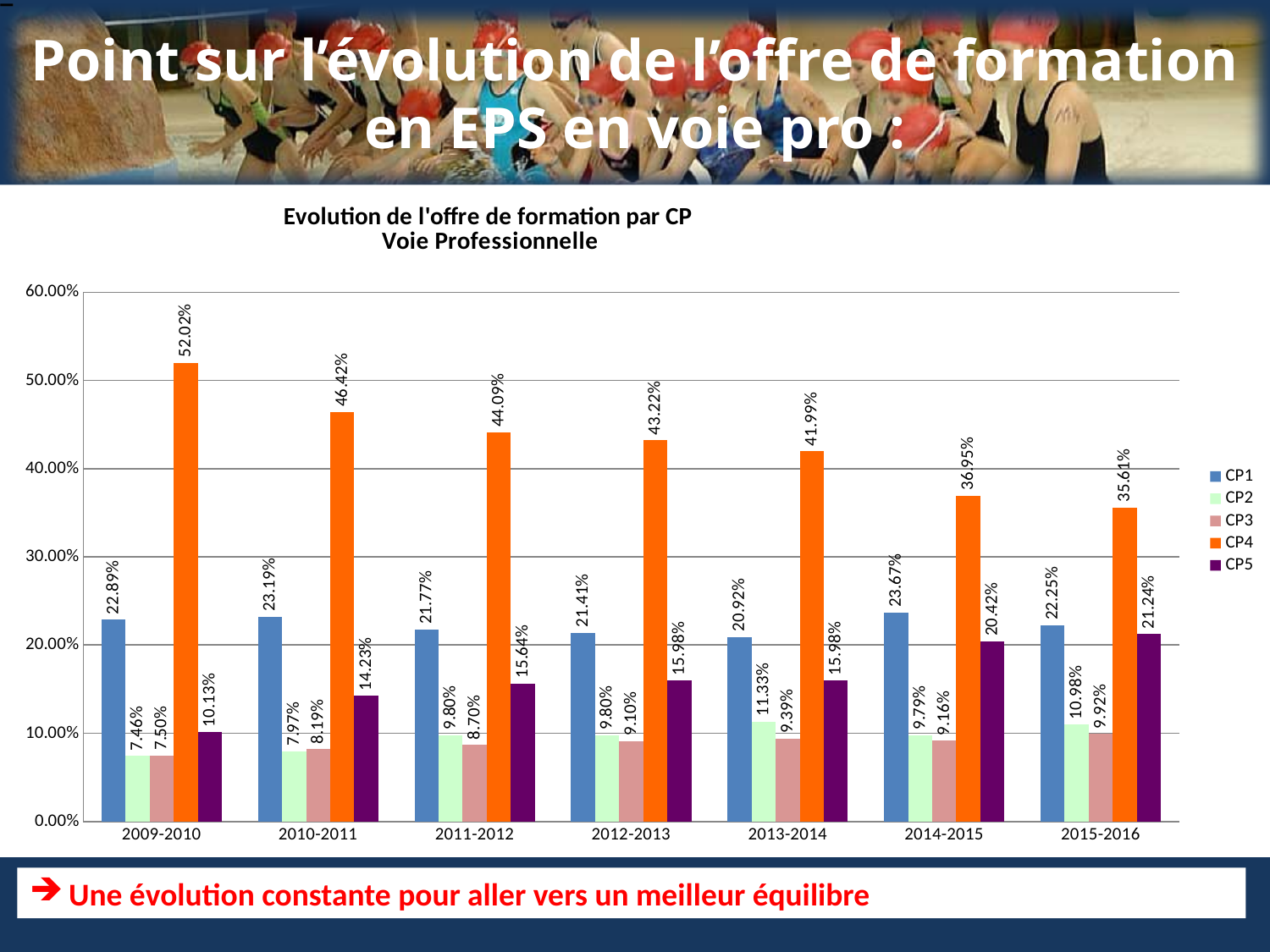
Which is larger in 2014-2015: CP1 or CP5? CP1 In which year is the CP2 value lowest? 2009-2010 What is the value for CP4 in 2009-2010? 52.02% Is the value for CP4 in 2013-2014 greater or less than 40.00%? greater What is the value for CP2 in 2013-2014? 11.33% How many school years are shown on the x axis? 7 In which year is the CP4 value highest? 2009-2010 Does the CP4 value rise or fall from 2009-2010 to 2015-2016? fall What is the value for CP5 in 2015-2016? 21.24% How many series does the legend list? 5 What kind of chart is shown on the slide? bar chart What is the difference between the CP4 value in 2009-2010 and in 2015-2016? 16.41%